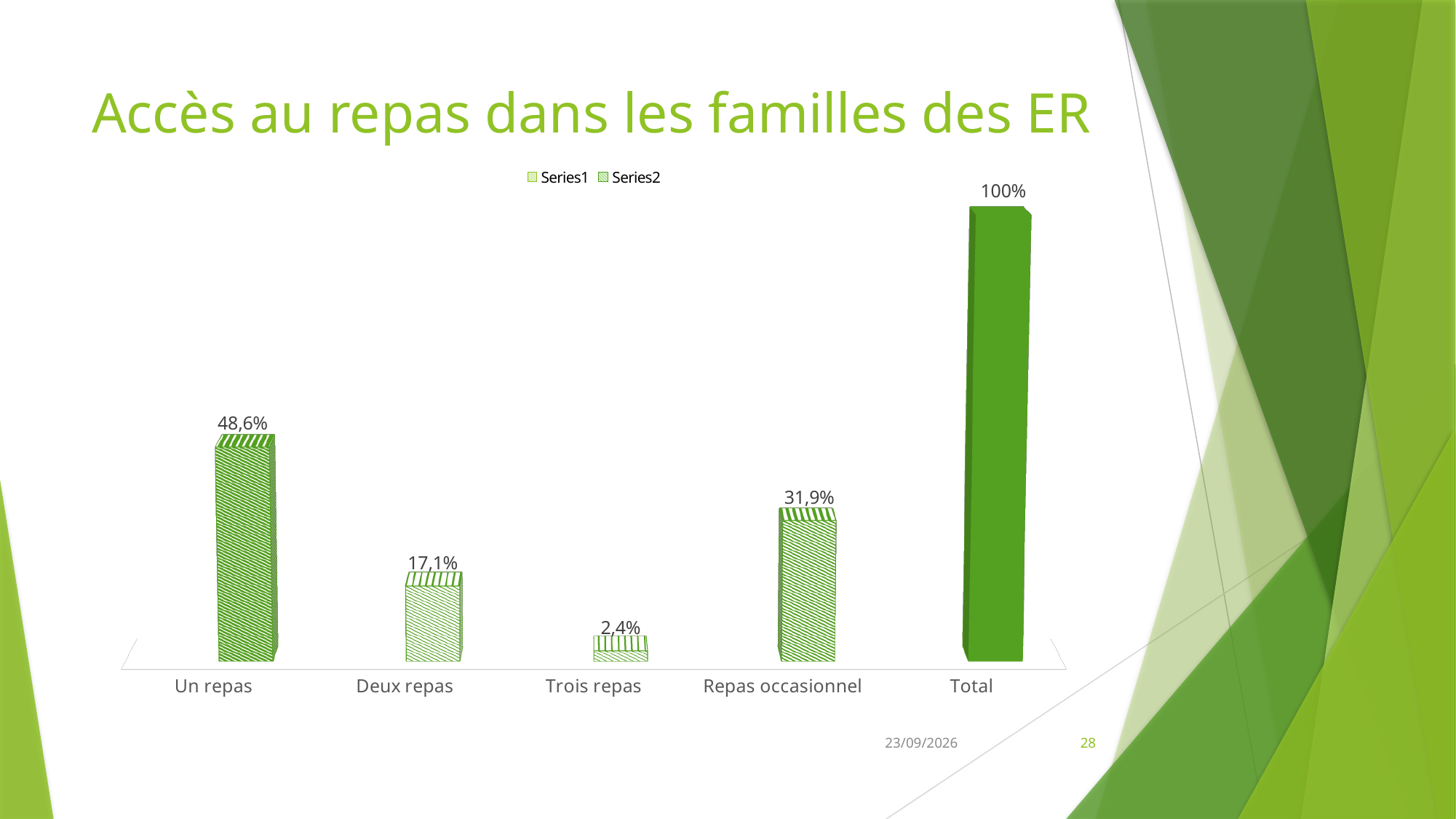
How many categories are shown on the x axis? 5 Which is larger, the value for Deux repas or the value for Repas occasionnel? Repas occasionnel Which category has the lowest value? Trois repas What is the value for Total? 100% What is the value for Repas occasionnel? 31,9% How many series does the legend list? 2 What is the value for Trois repas? 2,4% Excluding the Total bar, which category has the highest value? Un repas What is the value for Un repas? 48,6% What kind of chart is shown on the slide? Bar chart What is the value for Deux repas? 17,1% What is the difference between the values for Un repas and Repas occasionnel? 16,7%